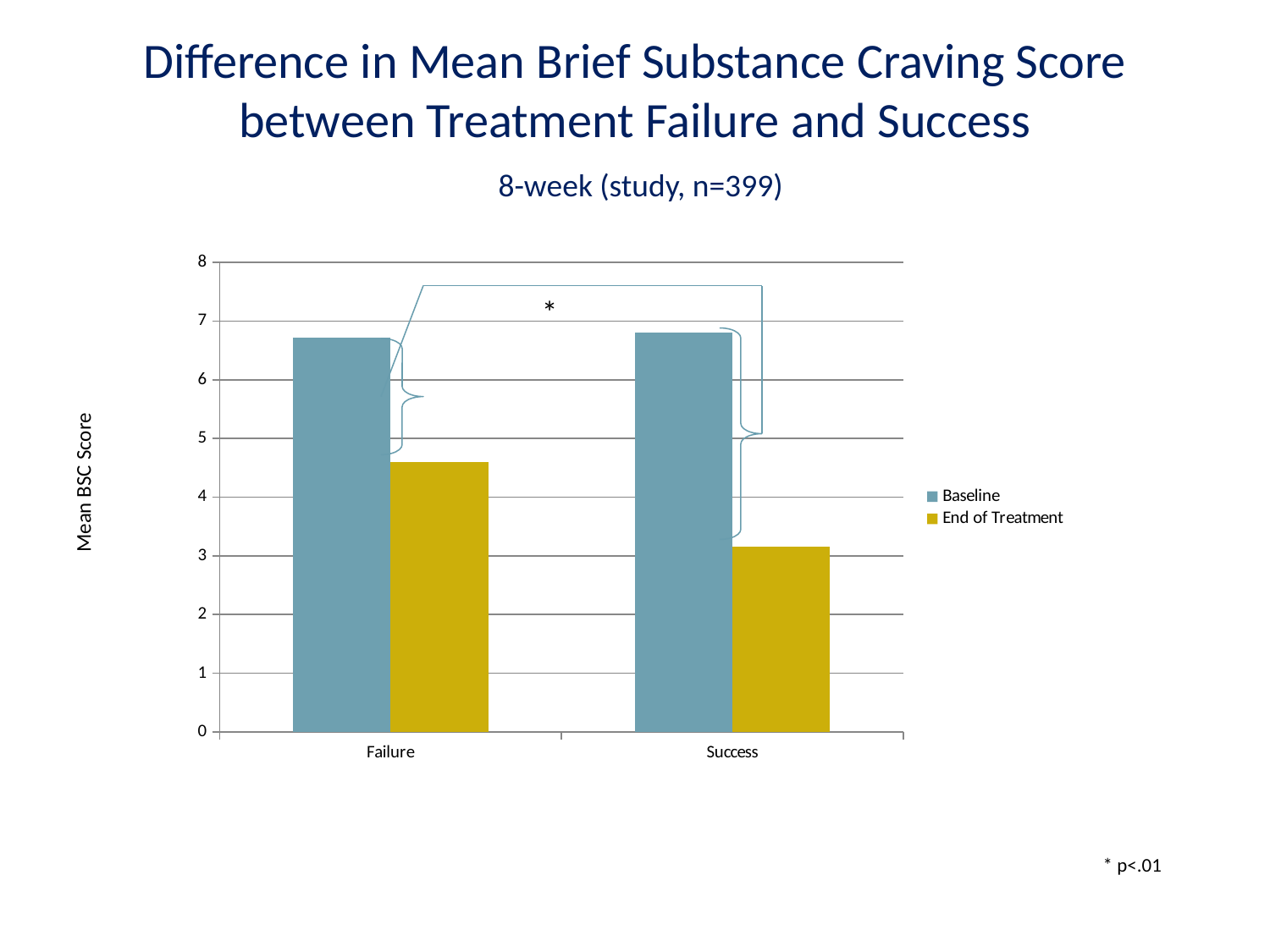
What kind of chart is shown on the slide? Bar chart Is the End of Treatment value for Failure greater or less than 5? less How many categories are shown on the x axis? 2 Which bar is the lowest on the chart? End of Treatment for Success Is the End of Treatment value for Success greater or less than 4? less Which series are listed in the legend? Baseline and End of Treatment How many series does the legend list? 2 Is the Baseline value for Success greater or less than 6? greater Which is larger for Success: the Baseline value or the End of Treatment value? Baseline Which category has the larger End of Treatment value, Failure or Success? Failure What is the label of the y axis? Mean BSC Score